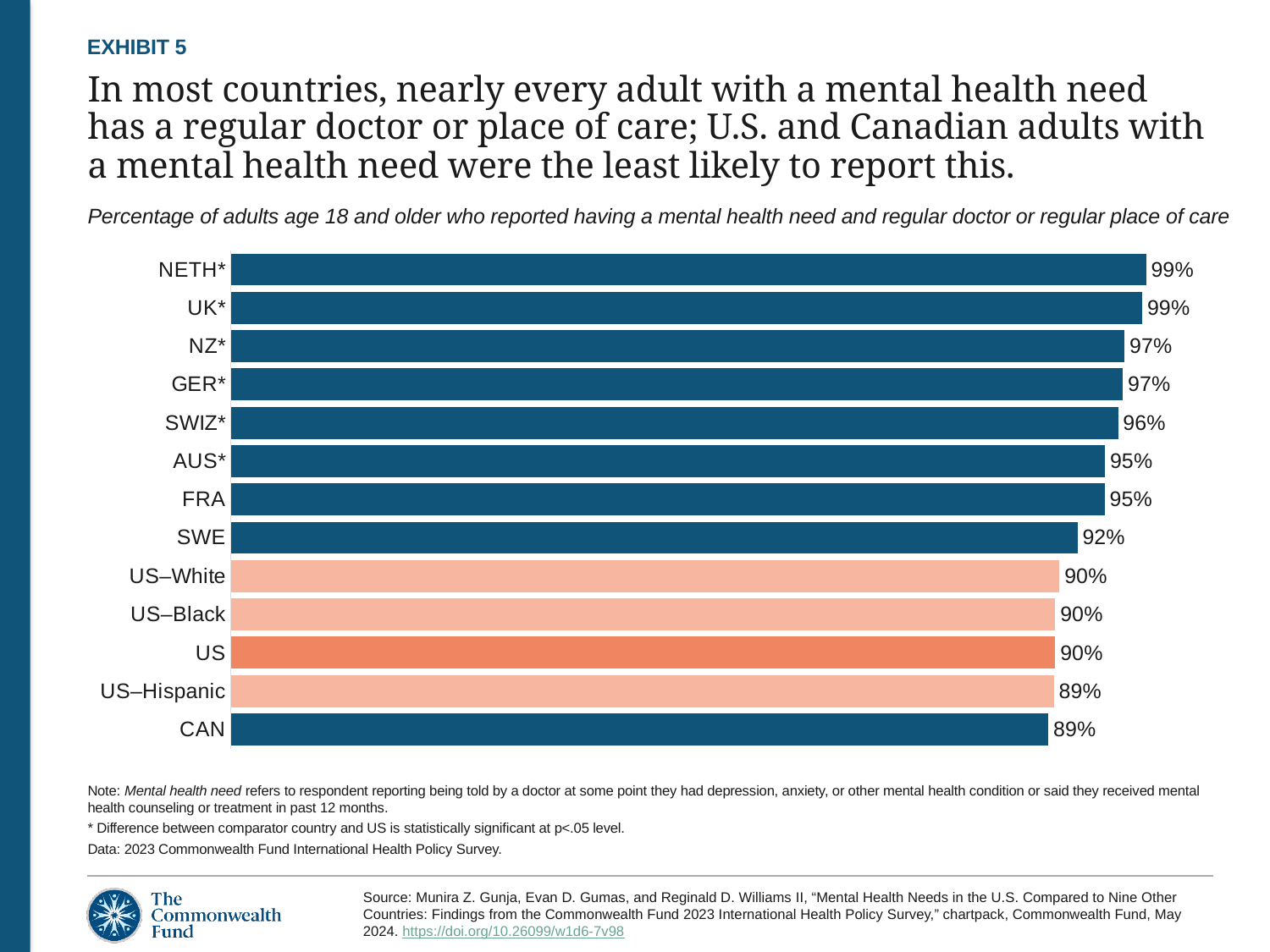
What is the value for US–Hispanic? 89% What is the value for NETH*? 99% How many categories (bars) are shown in the chart? 13 Which has a larger value, NZ* or AUS*? NZ* What is the difference between the values for SWE and US? 2 percentage points Which bar is shown in a darker orange colour than the other US bars? US Which has a larger value, FRA or SWE? FRA What percentage is shown for CAN? 89% What is the value for SWE? 92% What is the difference between the values for NETH* and CAN? 10 percentage points What kind of chart is shown on the slide? Bar chart What is the value for SWIZ*? 96%